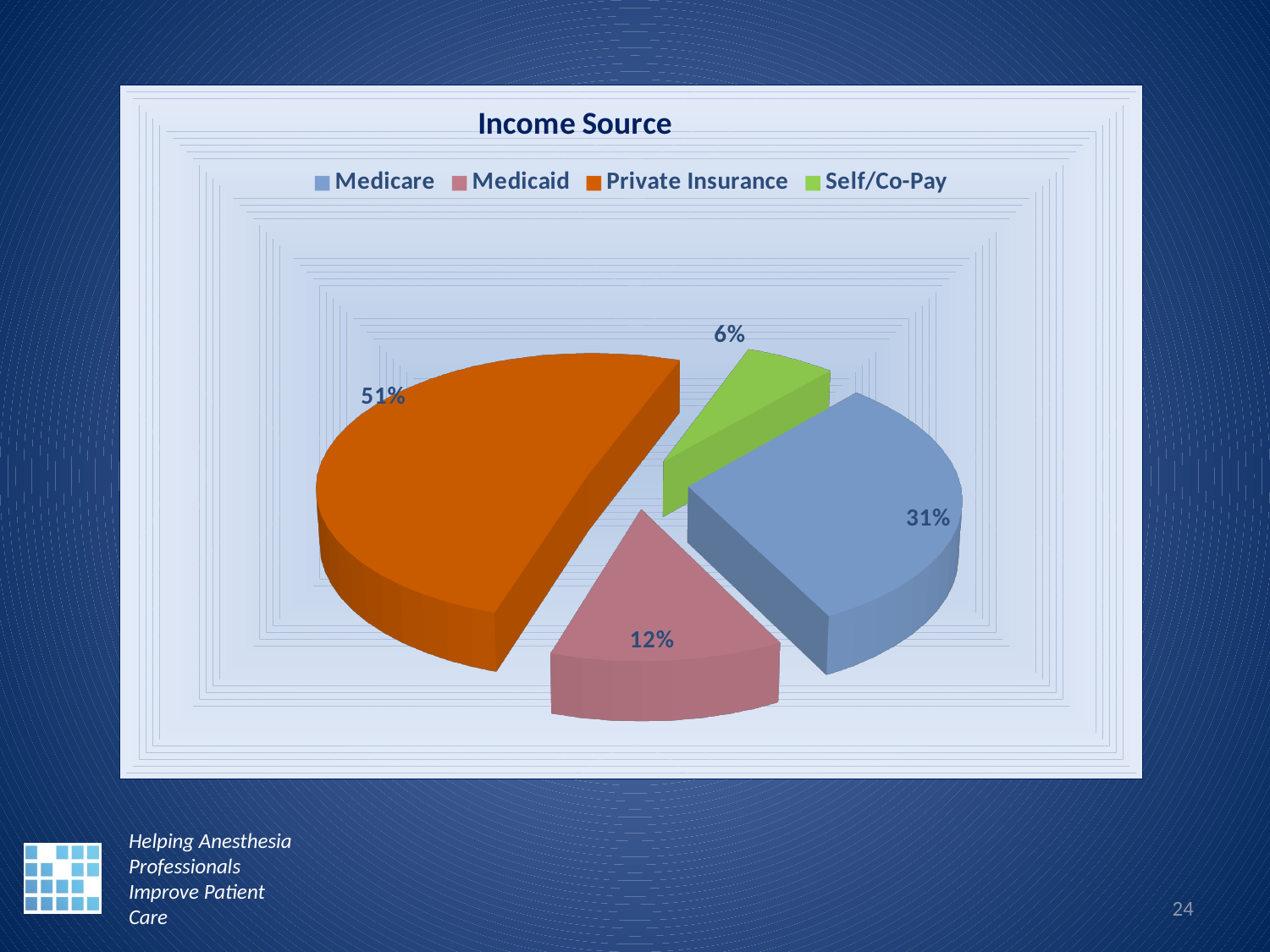
What type of chart is shown on the slide? Pie chart Which colour represents Medicare in the legend? Blue What is the title of the chart? Income Source Which income source has the largest share? Private Insurance What percentage of income comes from Medicaid? 12% What percentage of income comes from Private Insurance? 51% How many income source categories are shown in the pie chart? 4 What percentage of income comes from Self/Co-Pay? 6% Which is larger, the Medicaid share or the Self/Co-Pay share? Medicaid What is the difference in percentage points between Private Insurance and Medicare? 20 Which income source has the smallest share? Self/Co-Pay What percentage of income comes from Medicare? 31%